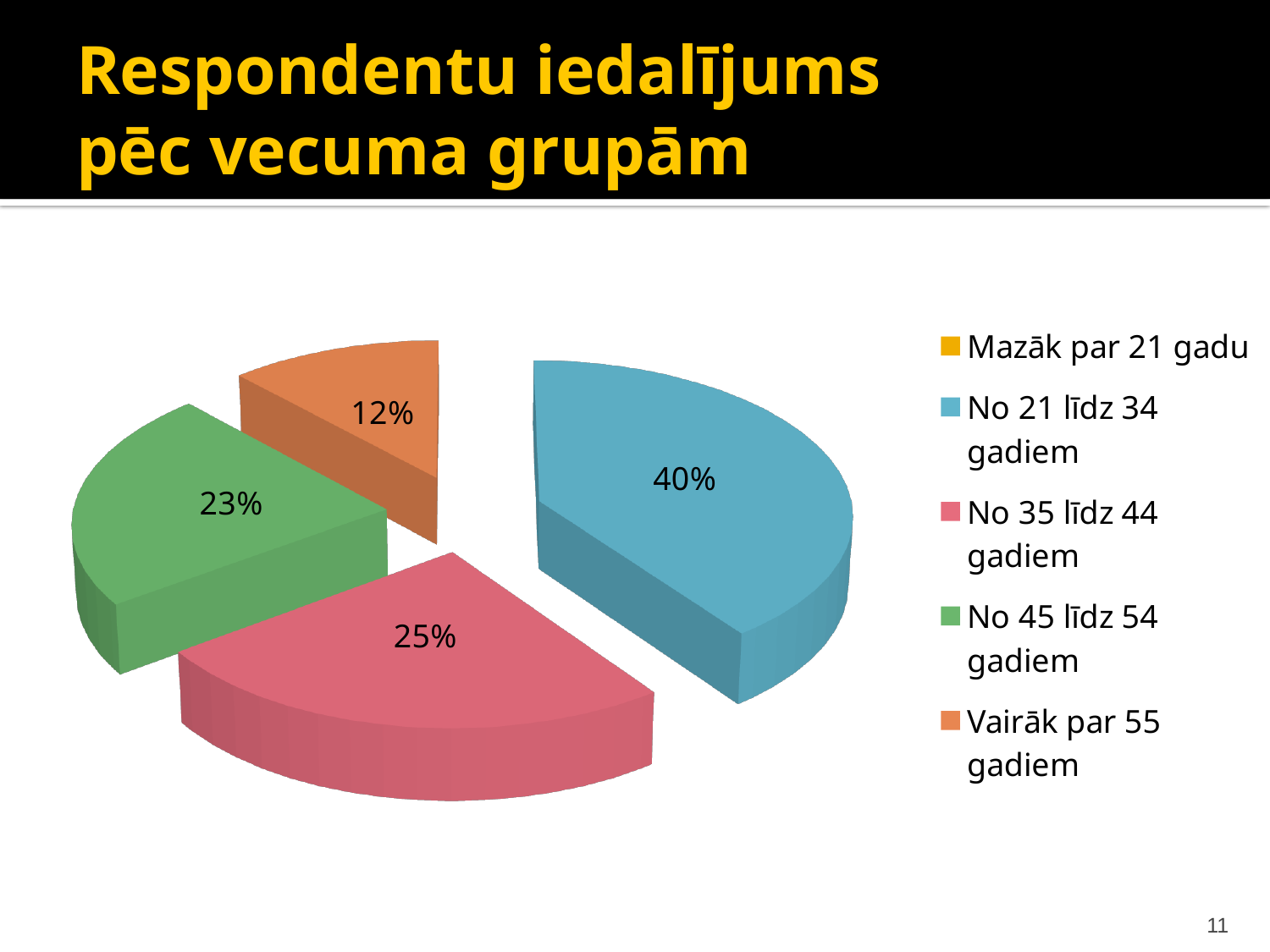
Which age group has the largest share of respondents? No 21 līdz 34 gadiem How many entries does the legend list? 5 What share of respondents are in the 'Vairāk par 55 gadiem' group? 12% Among the slices with printed labels, which age group has the smallest share? Vairāk par 55 gadiem Which group has a larger share: 'No 35 līdz 44 gadiem' or 'No 45 līdz 54 gadiem'? No 35 līdz 44 gadiem What share of respondents are in the 'No 21 līdz 34 gadiem' group? 40% What colour is the slice for 'No 21 līdz 34 gadiem'? blue What kind of chart is shown on the slide? pie chart What share of respondents are in the 'No 35 līdz 44 gadiem' group? 25% What is the difference in percentage points between the 'No 21 līdz 34 gadiem' and 'Vairāk par 55 gadiem' groups? 28 What share of respondents are in the 'No 45 līdz 54 gadiem' group? 23% What is the title of the slide containing the chart? Respondentu iedalījums pēc vecuma grupām